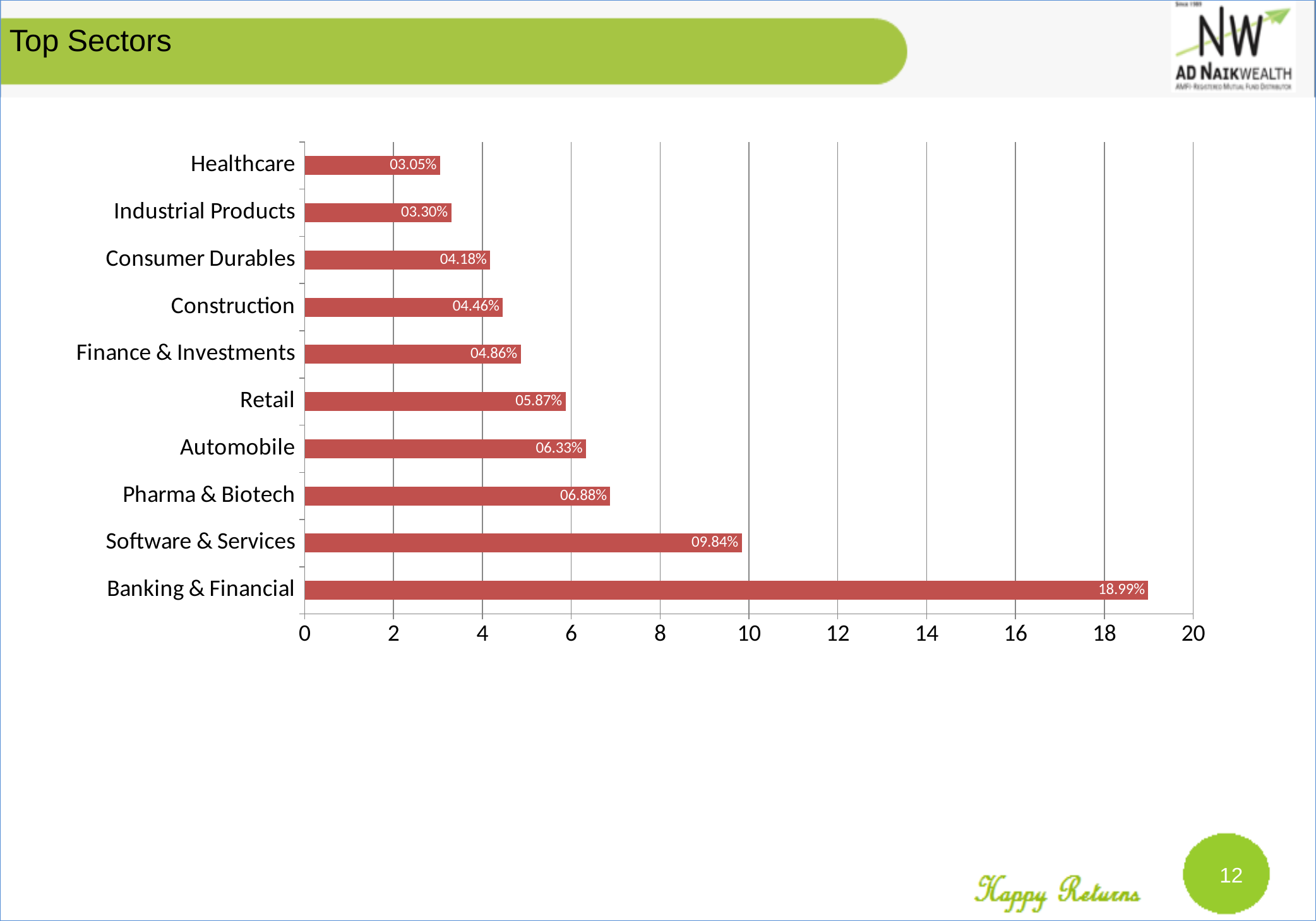
How many sectors are shown in the chart? 10 What is the value for Banking & Financial? 18.99% Which sector has the highest value? Banking & Financial What is the difference between Banking & Financial and Software & Services? 9.15% What is the difference between Pharma & Biotech and Automobile? 0.55% What is the value for Healthcare? 03.05% What kind of chart is shown on the slide? Bar chart What is the value for Retail? 05.87% What is the value for Software & Services? 09.84% Which sector has the lowest value? Healthcare What is the title of the slide containing the chart? Top Sectors Which is larger, Construction or Consumer Durables? Construction